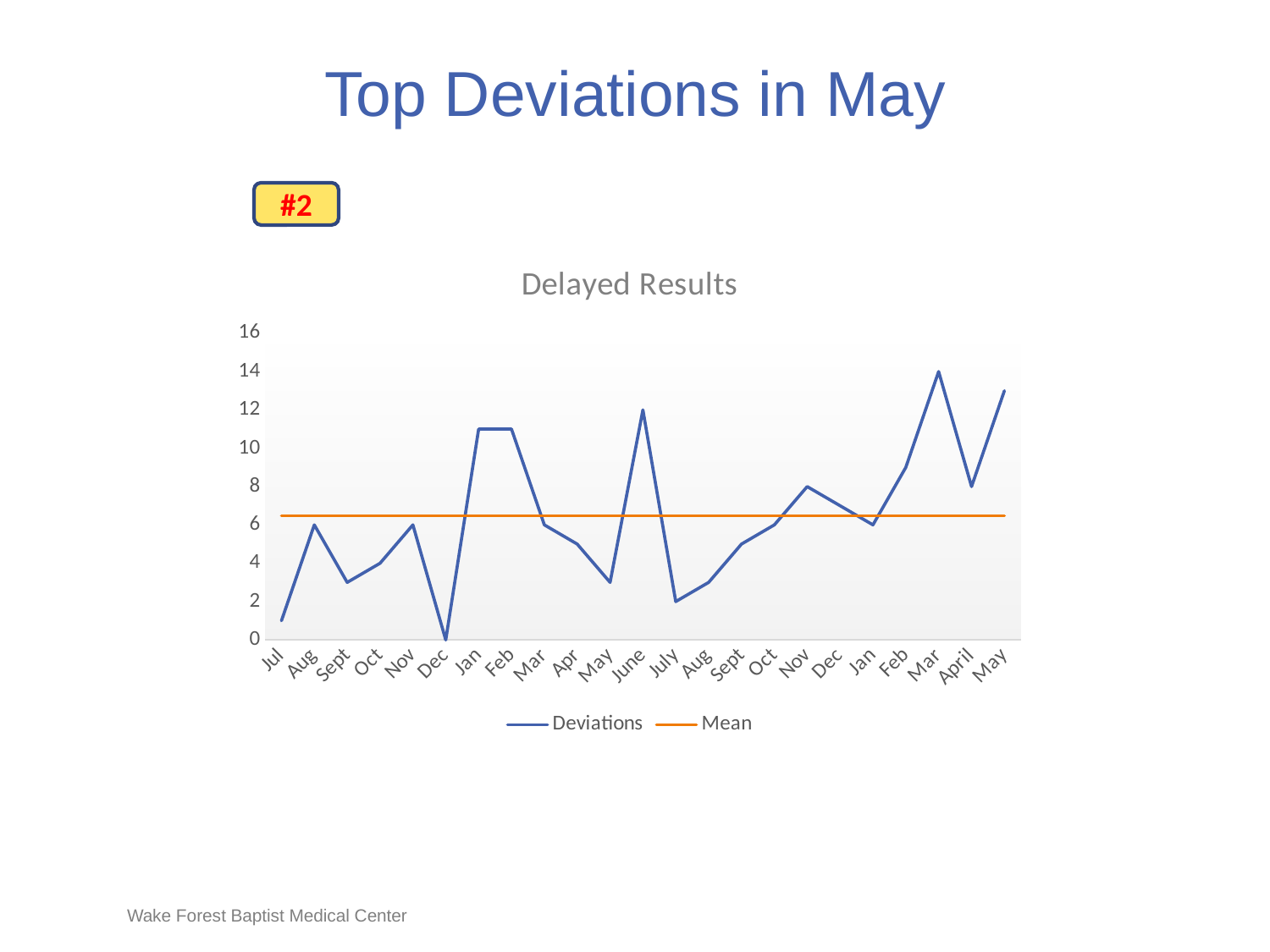
Is the Mean line greater or less than 6? greater How many months are plotted along the x axis? 23 Which month has the highest value for Deviations? the last Mar (near the right end) What are the two series named in the legend? Deviations and Mean Which is larger, the Deviations value for the first Jan or for the first Mar? the first Jan Which month has the lowest value for Deviations? the first Dec What kind of chart is shown on the slide? line chart What is the title of the chart? Delayed Results Is the Deviations value for July (the month after June) greater or less than 4? less How many series does the legend list? 2 Is the Deviations value for June greater or less than 10? greater What is the Deviations value for the first Dec on the x axis? 0